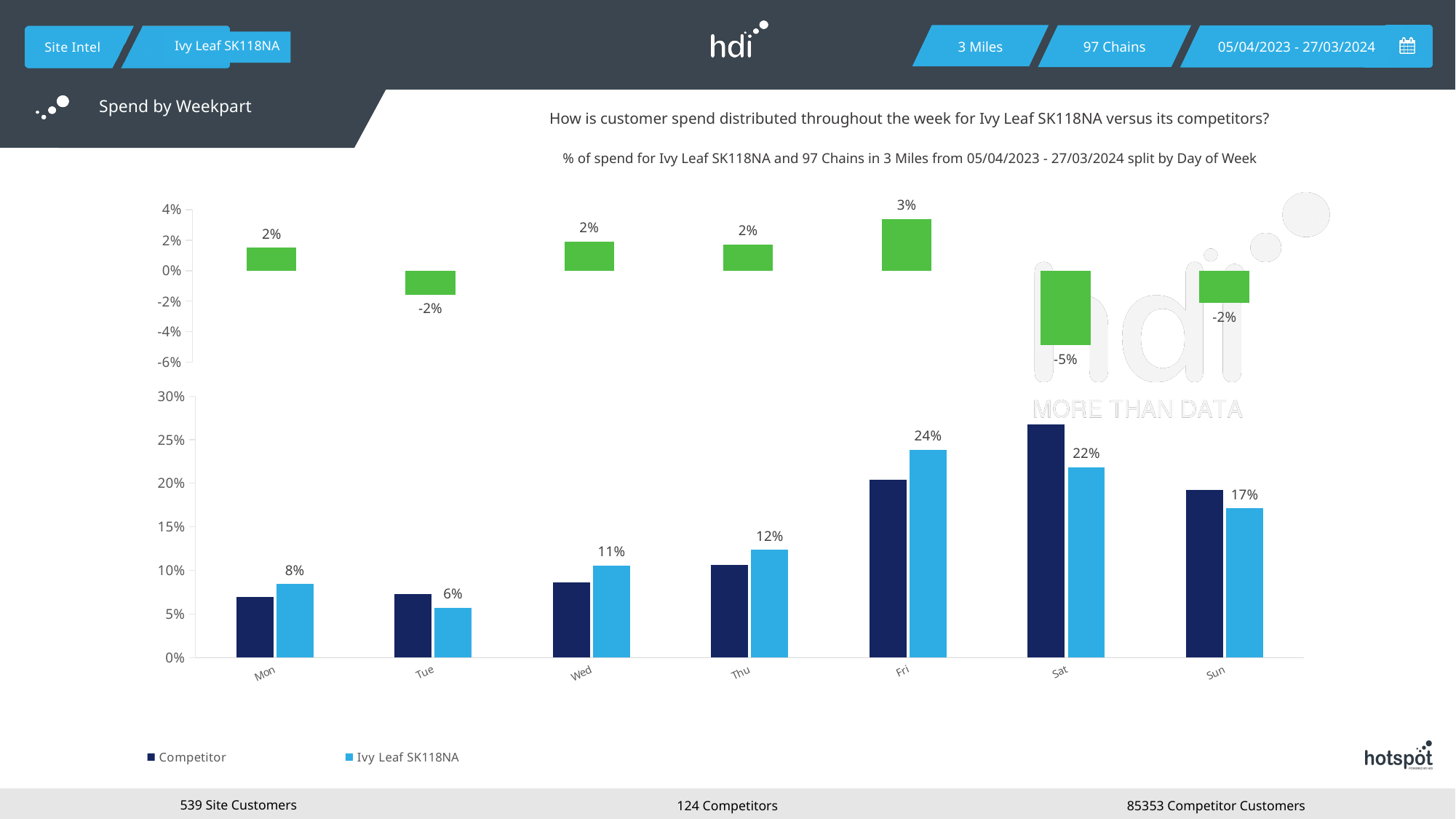
In the top chart (green bars), which day has the lowest value? Sat In the bottom chart, on which day is the Ivy Leaf SK118NA value lowest? Tue In the bottom chart, is the Competitor value for Sat greater or less than 25%? greater How many days of the week are shown on the x axis of the bottom chart? 7 In the bottom chart, on which day is the Ivy Leaf SK118NA value highest? Fri In the bottom chart, what is the difference between the Ivy Leaf SK118NA values for Fri and Sat? 2% In the bottom chart, on Sat, which series has the larger value: Competitor or Ivy Leaf SK118NA? Competitor How many series does the legend of the bottom chart list? 2 In the bottom chart, what is the value for Ivy Leaf SK118NA on Fri? 24% In the bottom chart, is the Competitor value for Mon greater or less than 10%? less In the top chart (green bars), what is the value shown for Sat? -5% What type of chart is the bottom chart? bar chart